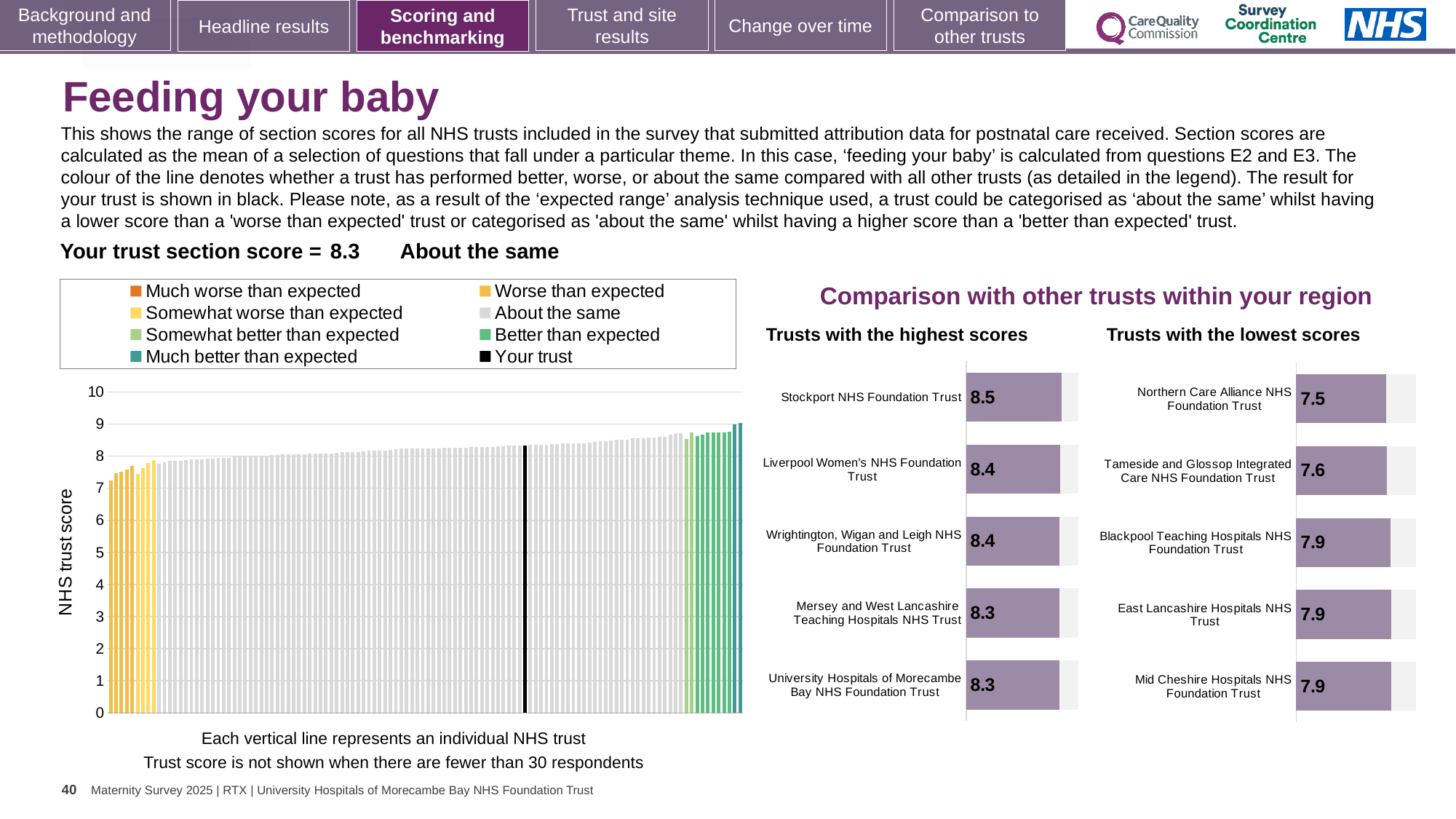
In the large 'NHS trust score' chart on the left, do the bar values rise or fall from left to right? Rise How many entries does the legend above the 'NHS trust score' chart list? 8 In the 'Trusts with the highest scores' chart, which trust has the highest score? Stockport NHS Foundation Trust In the 'Trusts with the lowest scores' chart, which has the higher score: Tameside and Glossop Integrated Care NHS Foundation Trust or Blackpool Teaching Hospitals NHS Foundation Trust? Blackpool Teaching Hospitals NHS Foundation Trust In the 'Trusts with the highest scores' chart, what is the difference between the scores of Stockport NHS Foundation Trust and University Hospitals of Morecambe Bay NHS Foundation Trust? 0.2 What is the y-axis label of the large chart on the left? NHS trust score How many trusts are shown in the 'Trusts with the highest scores' chart? 5 What kind of chart is the large 'NHS trust score' chart on the left? Bar chart In the 'Trusts with the lowest scores' chart, which trust has the lowest score? Northern Care Alliance NHS Foundation Trust In the 'Trusts with the highest scores' chart, what is the score for Stockport NHS Foundation Trust? 8.5 In the large 'NHS trust score' chart on the left, is the value of the black 'Your trust' bar greater or less than 8? greater In the 'Trusts with the lowest scores' chart, what is the score for Northern Care Alliance NHS Foundation Trust? 7.5